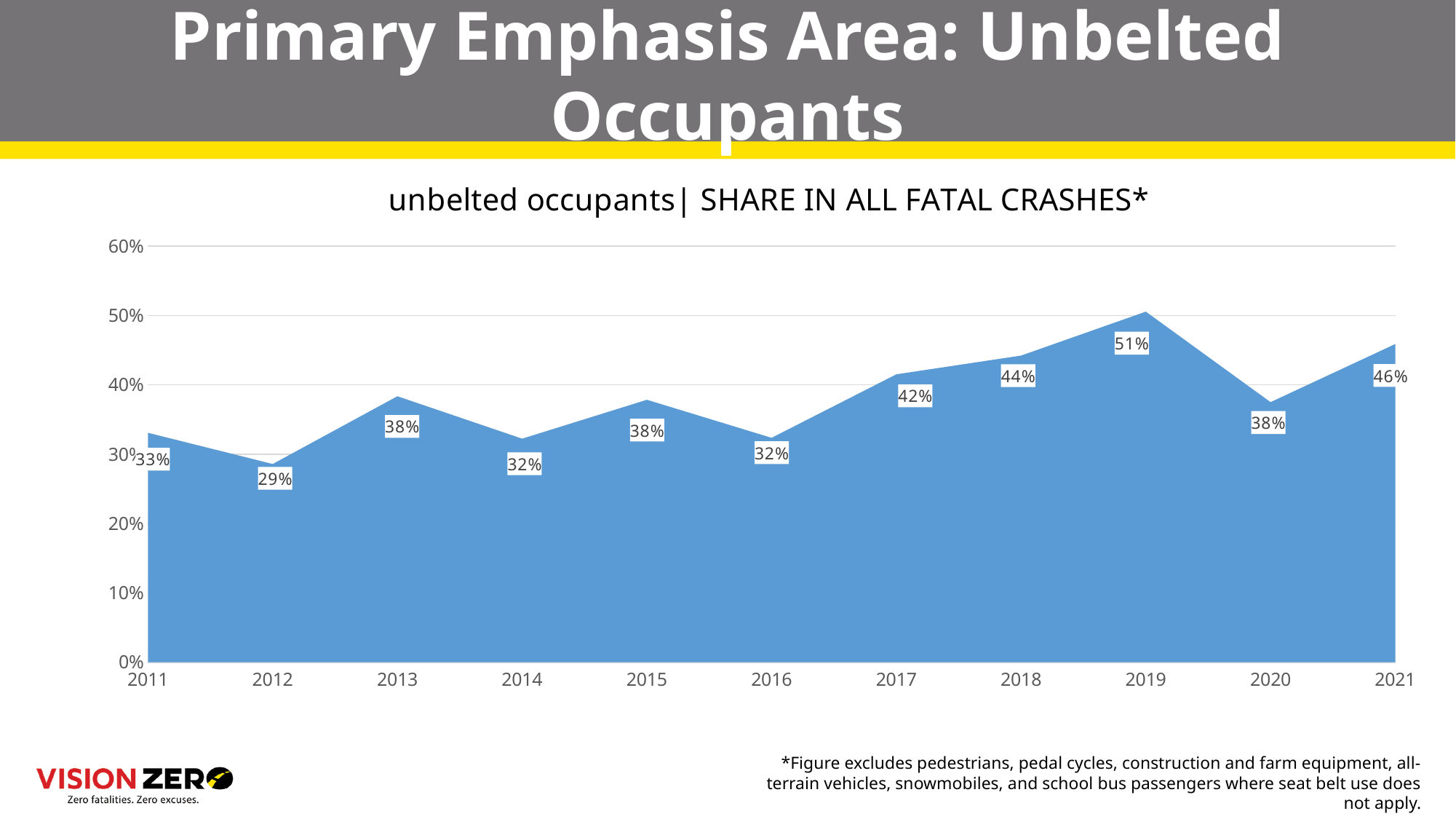
What is the share of unbelted occupants in all fatal crashes in 2021? 46% How many years are shown on the x axis of the chart? 11 Which year has the lowest share of unbelted occupants in all fatal crashes? 2012 Which year has the highest share of unbelted occupants in all fatal crashes? 2019 What is the share of unbelted occupants in all fatal crashes in 2012? 29% Which year has a larger share of unbelted occupants in fatal crashes, 2017 or 2018? 2018 Is the value for 2016 greater or less than 40%? less Does the share of unbelted occupants in fatal crashes rise or fall from 2016 to 2019? rise What is the title of the chart? unbelted occupants| SHARE IN ALL FATAL CRASHES* What is the difference in percentage points between the 2019 and 2020 shares? 13 What kind of chart is shown on the slide? area chart What is the share of unbelted occupants in all fatal crashes in 2019? 51%